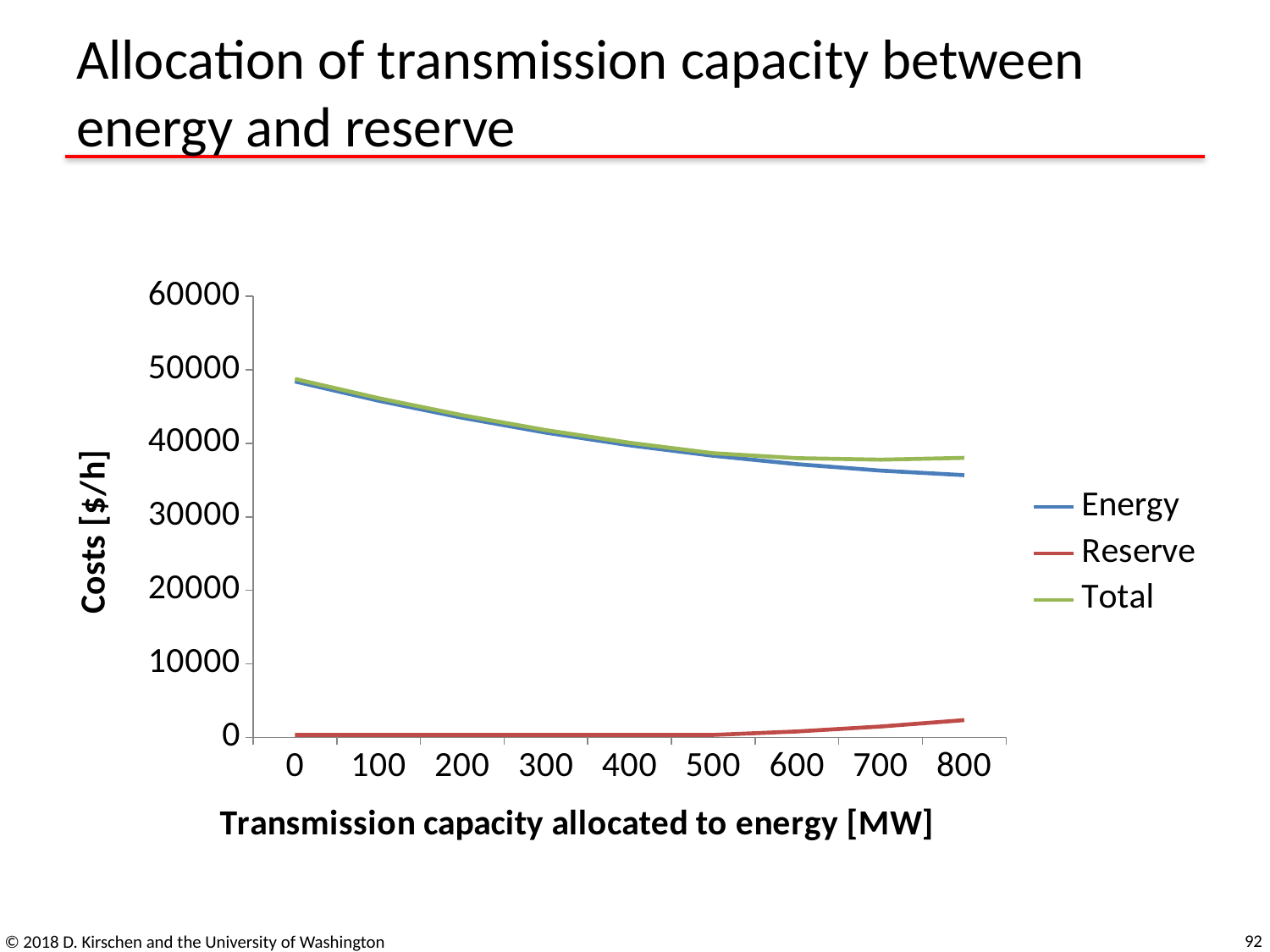
What are the series names listed in the legend? Energy, Reserve, Total At 400 MW, which is larger, the Energy cost or the Reserve cost? Energy What kind of chart is shown on the slide? line chart Does the Reserve cost rise or fall between 500 MW and 800 MW? rise Does the Energy cost rise or fall as the transmission capacity allocated to energy increases from 0 to 800 MW? fall Which series has the lowest values across the whole chart? Reserve Is the Reserve cost at 800 MW greater or less than 10000? less Is the Energy cost at 0 MW greater or less than 40000? greater Is the Energy cost at 800 MW greater or less than 40000? less How many series does the legend list? 3 At 800 MW, which is larger, the Total cost or the Energy cost? Total What is the title of the vertical axis? Costs [$/h]